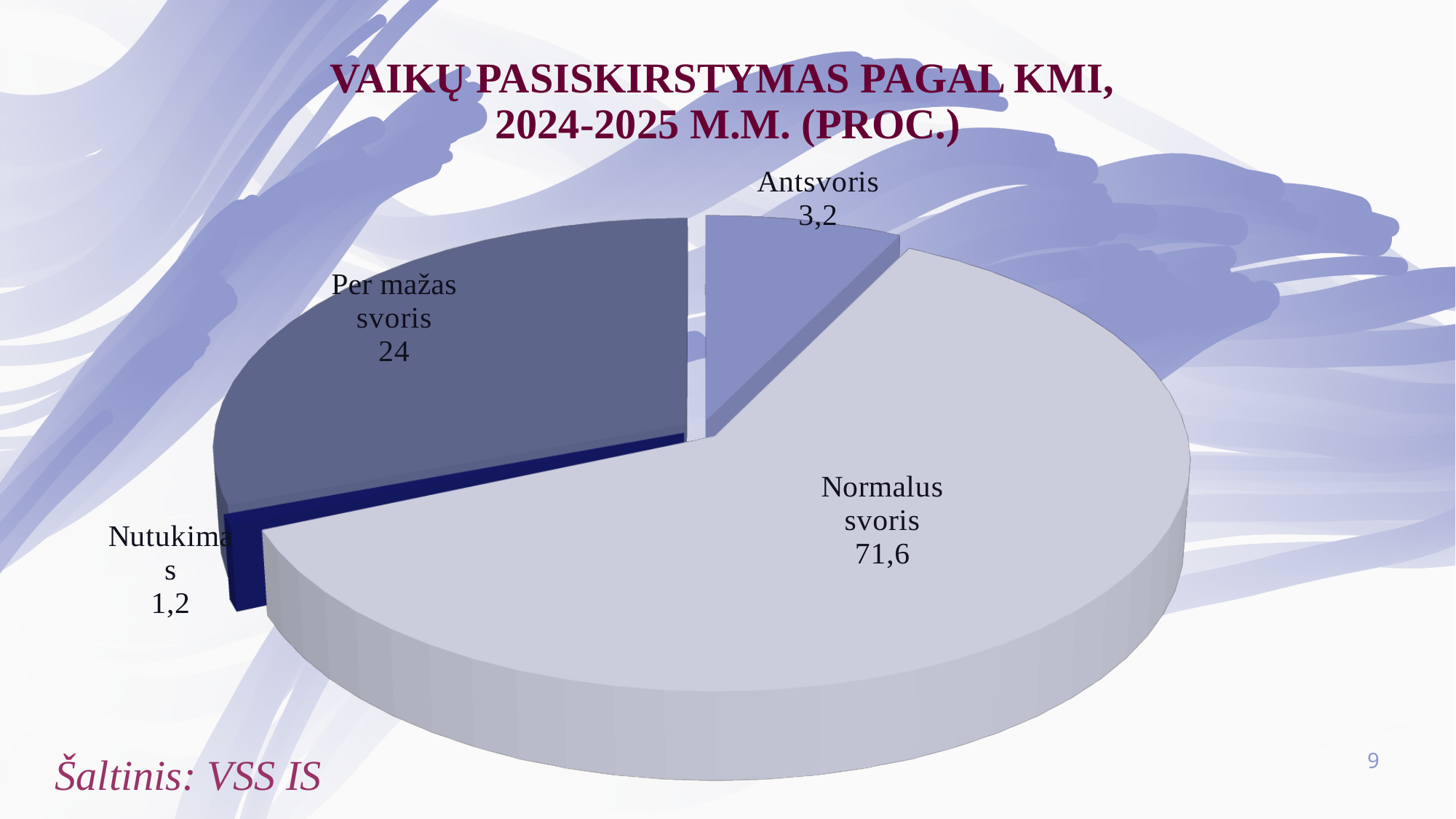
Which category has the smallest share of the pie? Nutukimas What is the value for Normalus svoris? 71,6 How many categories (slices) does the pie chart have? 4 What is the value for Per mažas svoris? 24 What is the value for Nutukimas? 1,2 What is the difference between the values for Normalus svoris and Per mažas svoris? 47,6 Which category has the largest share of the pie? Normalus svoris What is the difference between the values for Antsvoris and Nutukimas? 2 What is the value for Antsvoris? 3,2 What is the title of the chart? VAIKŲ PASISKIRSTYMAS PAGAL KMI, 2024-2025 M.M. (PROC.) Which is larger, the value for Per mažas svoris or the value for Antsvoris? Per mažas svoris What type of chart is shown on the slide? Pie chart